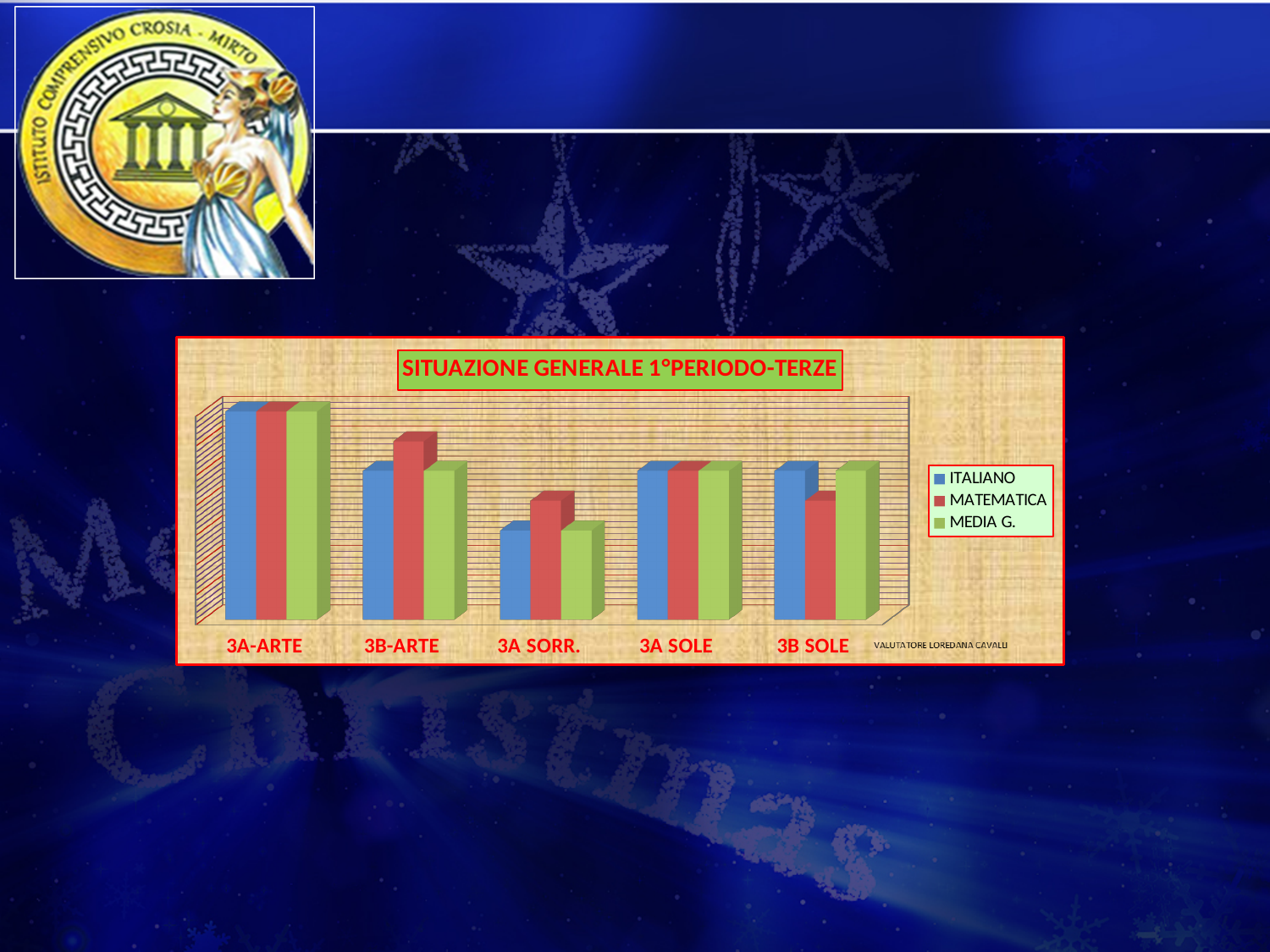
For 3B SOLE, which is higher: the ITALIANO bar or the MATEMATICA bar? ITALIANO How many classes (categories) are shown along the x axis of the chart? 5 Which class has the higher ITALIANO bar, 3A-ARTE or 3B-ARTE? 3A-ARTE Which class has the lowest ITALIANO bar? 3A SORR. Which class has the highest ITALIANO bar? 3A-ARTE Which series is shown in green in the chart's legend? MEDIA G. For 3B-ARTE, which is higher: the ITALIANO bar or the MATEMATICA bar? MATEMATICA Which class has the lowest MEDIA G. bar? 3A SORR. What is the title of the chart? SITUAZIONE GENERALE 1°PERIODO-TERZE How many series does the chart's legend list? 3 Which class has the highest MATEMATICA bar? 3A-ARTE What kind of chart is shown on the slide? bar chart